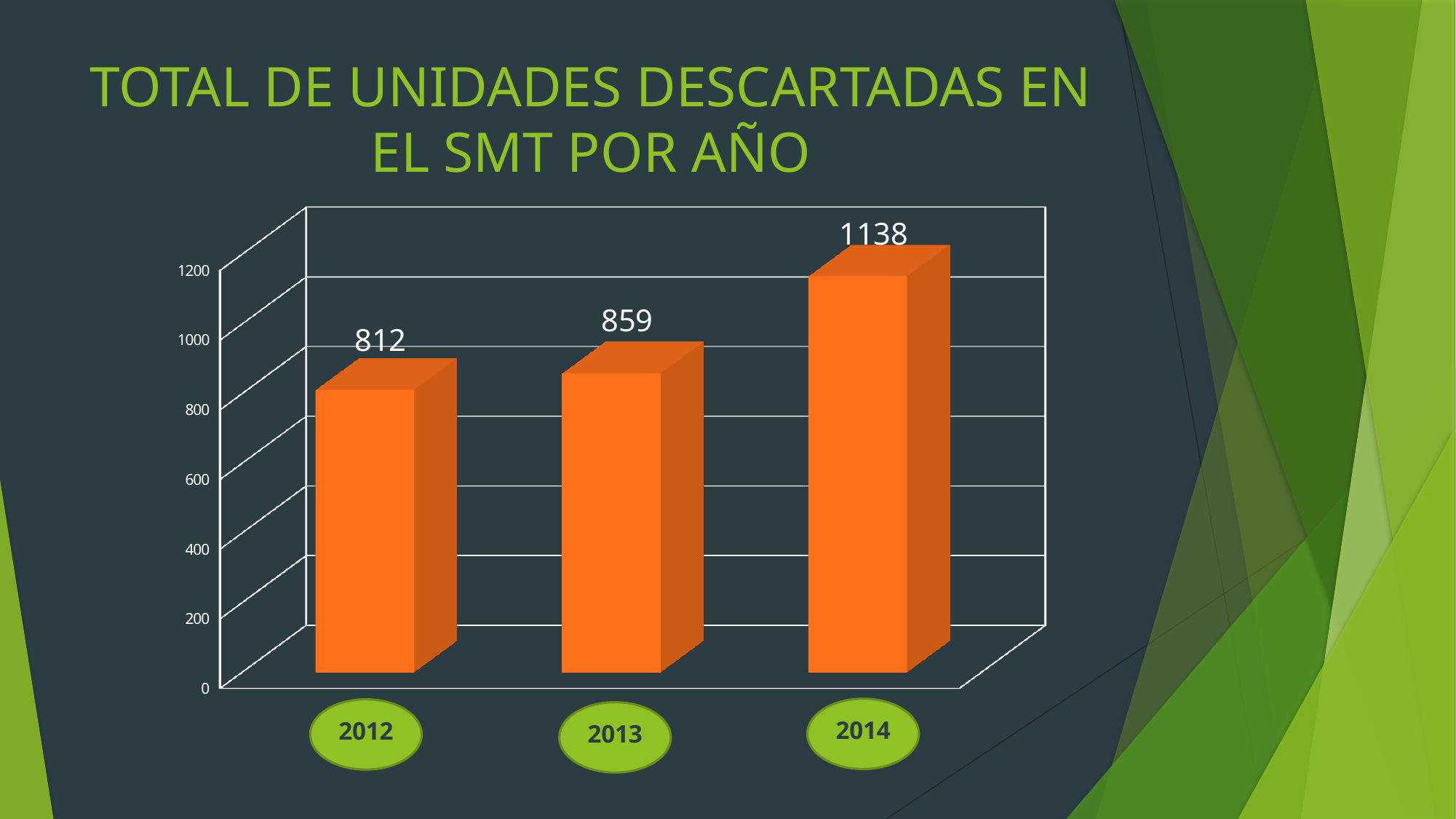
What is the difference between the values for 2013 and 2012? 47 What is the value for 2014? 1138 What kind of chart is shown on the slide? bar chart Do the values rise or fall from 2012 to 2014? rise What is the difference between the values for 2014 and 2012? 326 How many years are shown on the chart? 3 Which is larger, the value for 2013 or the value for 2014? 2014 What is the value for 2012? 812 Which year has the highest value? 2014 Which year has the lowest value? 2012 Is the value for 2014 greater or less than 1000? greater What is the value for 2013? 859